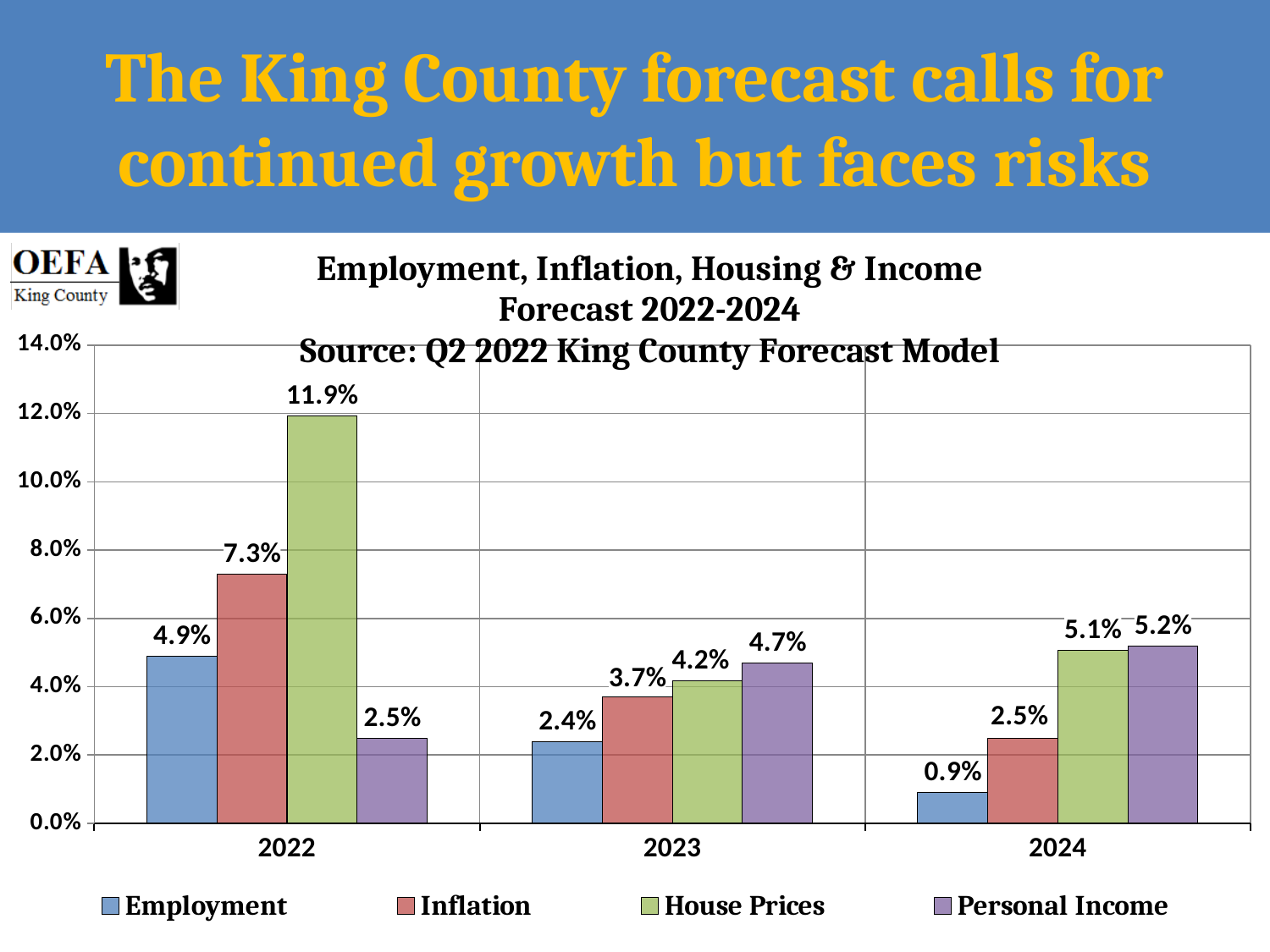
How many years are shown on the x axis? 3 How many series does the legend list? 4 What is the forecast value for House Prices in 2022? 11.9% What is the forecast value for Personal Income in 2024? 5.2% Does the Employment value rise or fall from 2022 to 2024? Fall What kind of chart is shown on the slide? Bar chart Which series has the lowest value in 2024? Employment What is the difference between the Inflation value in 2022 and the Inflation value in 2023? 3.6% Which is larger, the Employment value in 2022 or the Employment value in 2023? 2022 What is the forecast value for Employment in 2024? 0.9% Which series has the highest value in 2022? House Prices What is the forecast value for Inflation in 2023? 3.7%